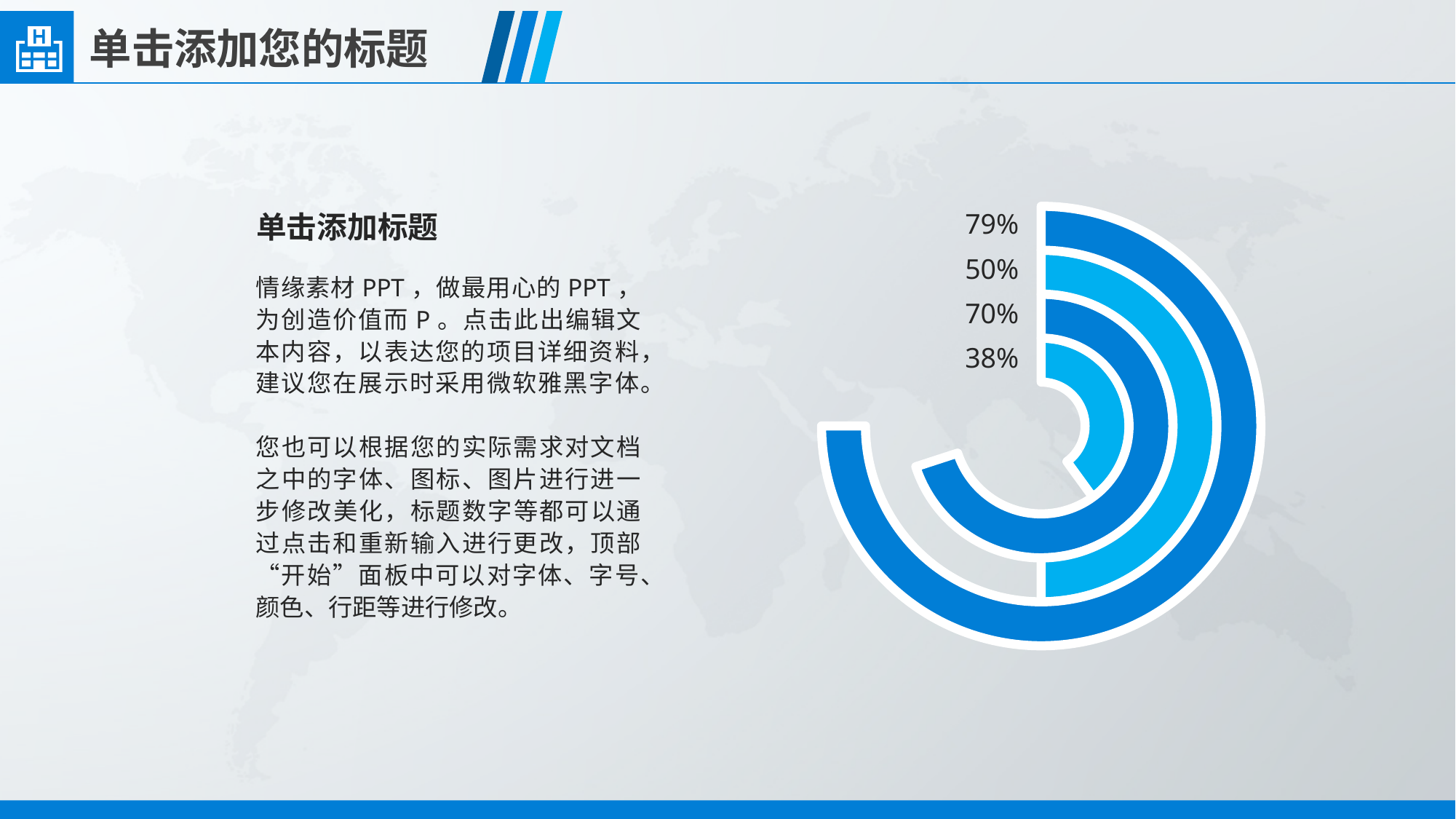
How many rings (data values) does the chart show? 4 Which ring has the lowest value? The innermost ring (38%) What value is shown for the third ring from the outside? 70% What value is shown for the innermost ring of the chart? 38% What colours are used for the rings of the chart? Alternating dark blue and light blue What value is shown for the outermost ring of the chart? 79% Which is larger, the value of the second ring from the outside or the third ring from the outside? The third ring (70%) What is the difference between the 70% ring and the 50% ring? 20% What kind of chart is shown on the slide? A doughnut (concentric ring) chart What value is shown for the second ring from the outside? 50% What is the difference between the highest and lowest values shown on the chart? 41% Which ring has the highest value? The outermost ring (79%)